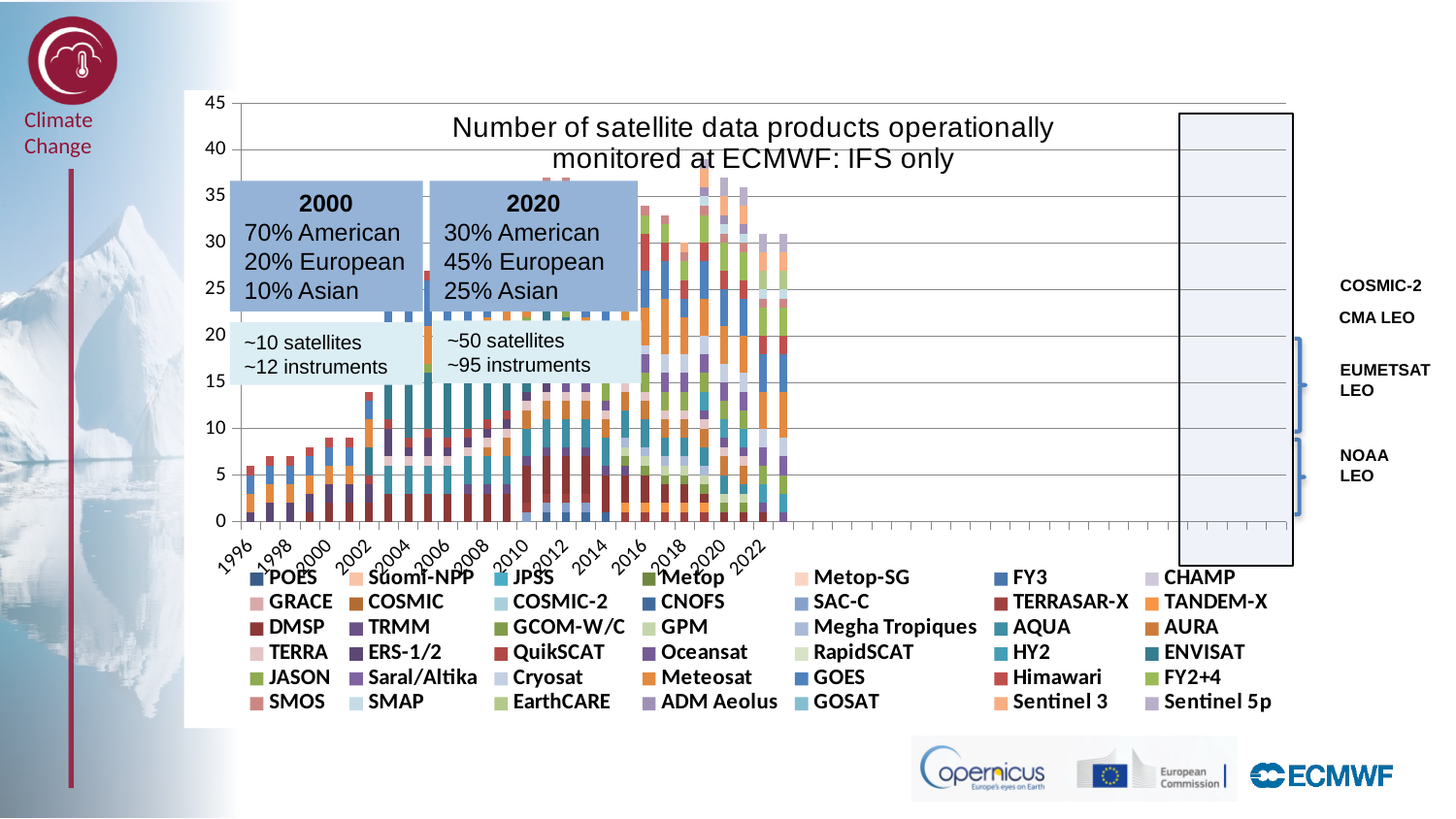
Is the total value for 1996 greater or less than 10? less Is the total value for 2002 greater or less than 10? greater What kind of chart is shown on the slide? Stacked bar chart Which year has a larger total, 2002 or 2010? 2010 Which year has the shortest stacked bar in the chart? 1996 Is the total value for 2022 greater or less than 25? greater What is the maximum value shown on the vertical axis? 45 What is the title of the chart? Number of satellite data products operationally monitored at ECMWF: IFS only Which year has the tallest stacked bar in the chart? 2020 Do the total values generally rise or fall from 1996 to 2020? rise Which year has a larger total, 1996 or 2022? 2022